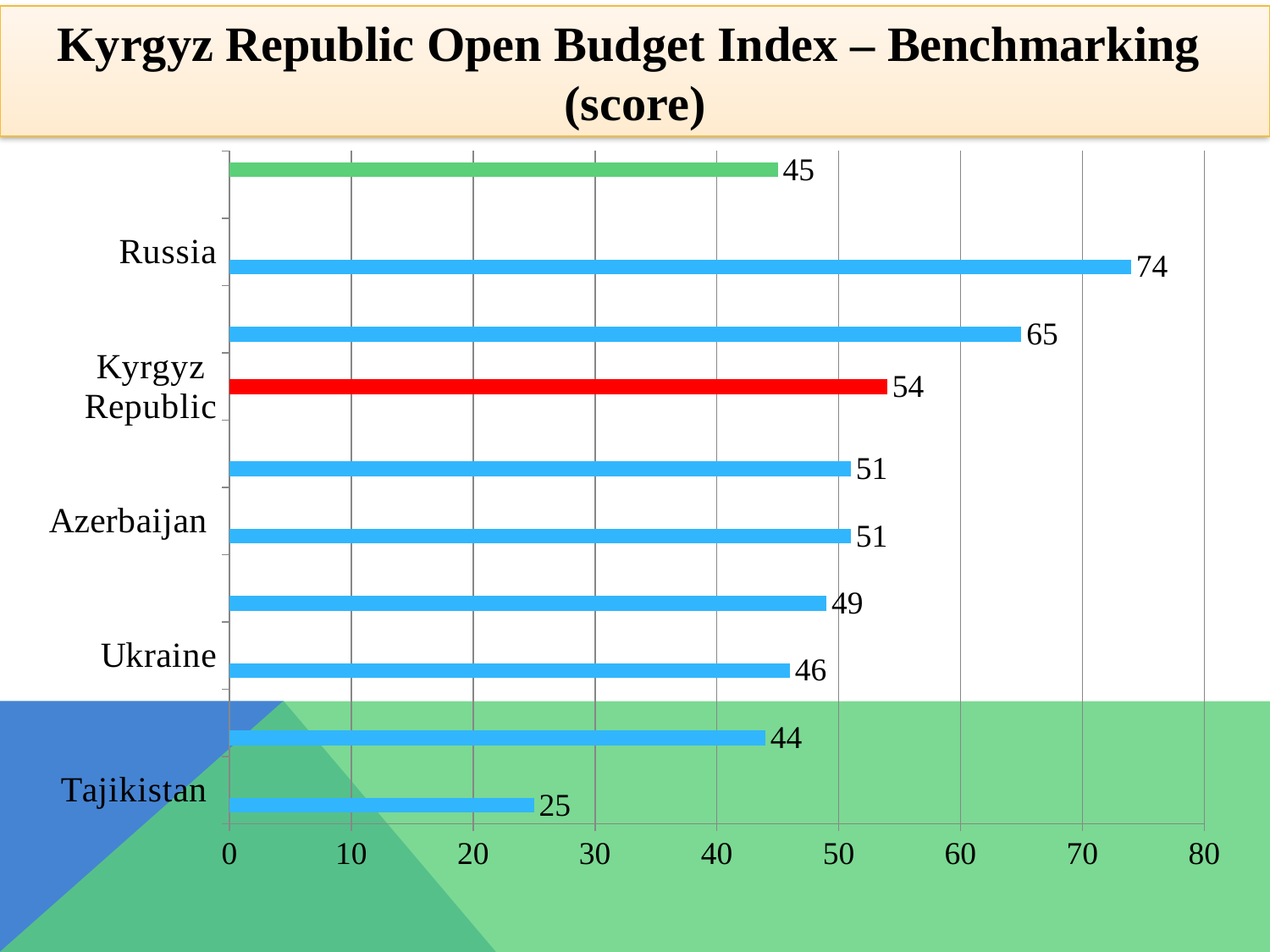
Which labelled country has the highest score? Russia Which has a higher score, Azerbaijan or Ukraine? Azerbaijan What colour is the bar for the Kyrgyz Republic? red What type of chart is shown on the slide? bar chart What is the title of the chart? Kyrgyz Republic Open Budget Index – Benchmarking (score) What is the difference between the scores of Russia and the Kyrgyz Republic? 20 How many bars are plotted in the chart? 10 What is the score for Tajikistan? 25 What is the score for the Kyrgyz Republic? 54 What is the score for Russia? 74 Which labelled country has the lowest score? Tajikistan What is the score for Ukraine? 46